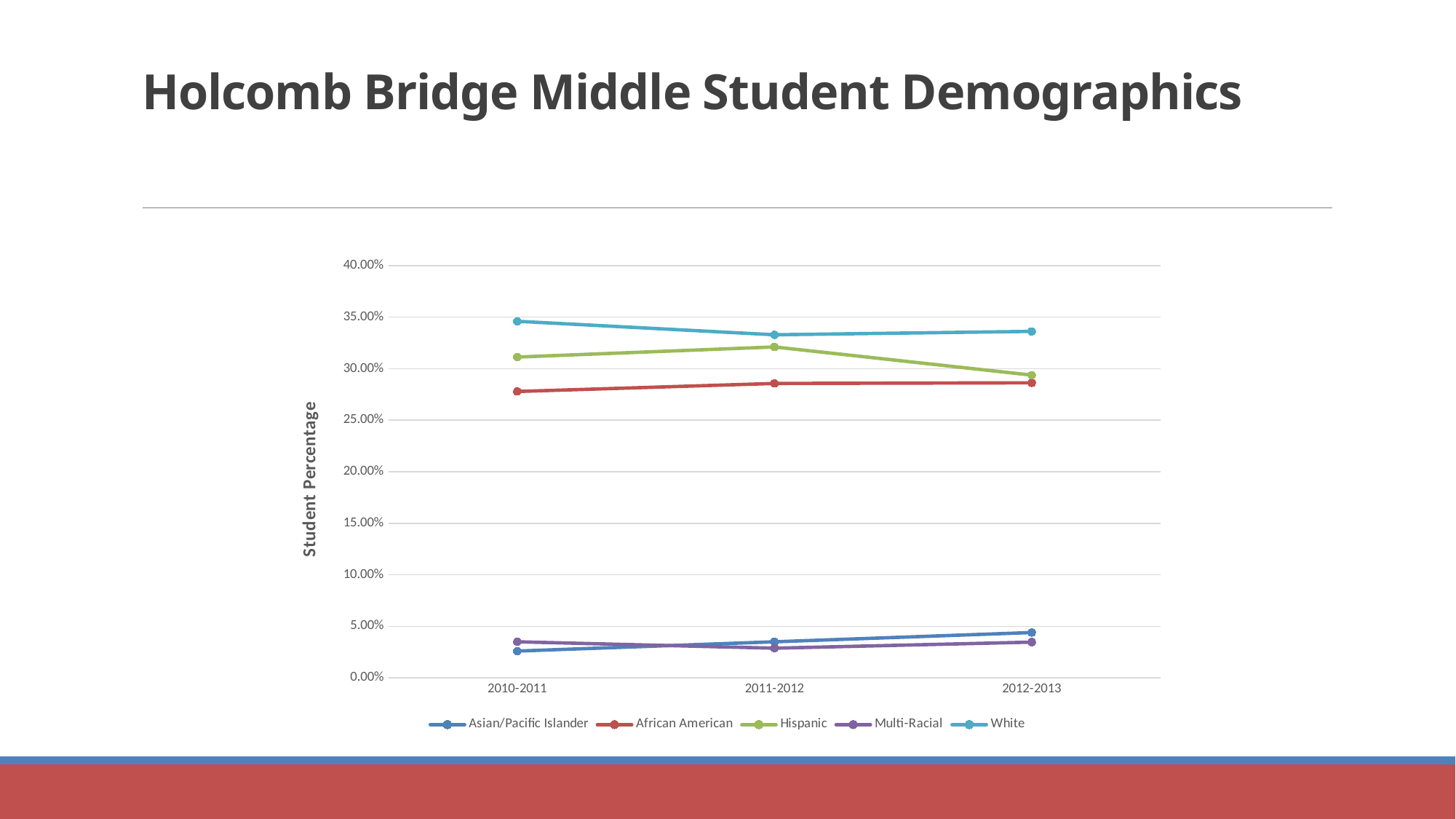
Does the Asian/Pacific Islander line rise or fall from 2010-2011 to 2012-2013? rises How many series does the legend list? 5 Is the value for Hispanic in 2012-2013 greater or less than 30.00%? less Is the value for Asian/Pacific Islander in 2012-2013 greater or less than 5.00%? less Which group has the lowest student percentage in 2010-2011? Asian/Pacific Islander Is the value for White in 2010-2011 greater or less than 30.00%? greater How many school years are plotted along the x axis? 3 Which group has the highest student percentage in 2010-2011? White What kind of chart is shown on the slide? line chart What is the title of the vertical axis? Student Percentage In 2011-2012, which is larger: the Hispanic value or the African American value? Hispanic Which group has the highest student percentage in 2012-2013? White